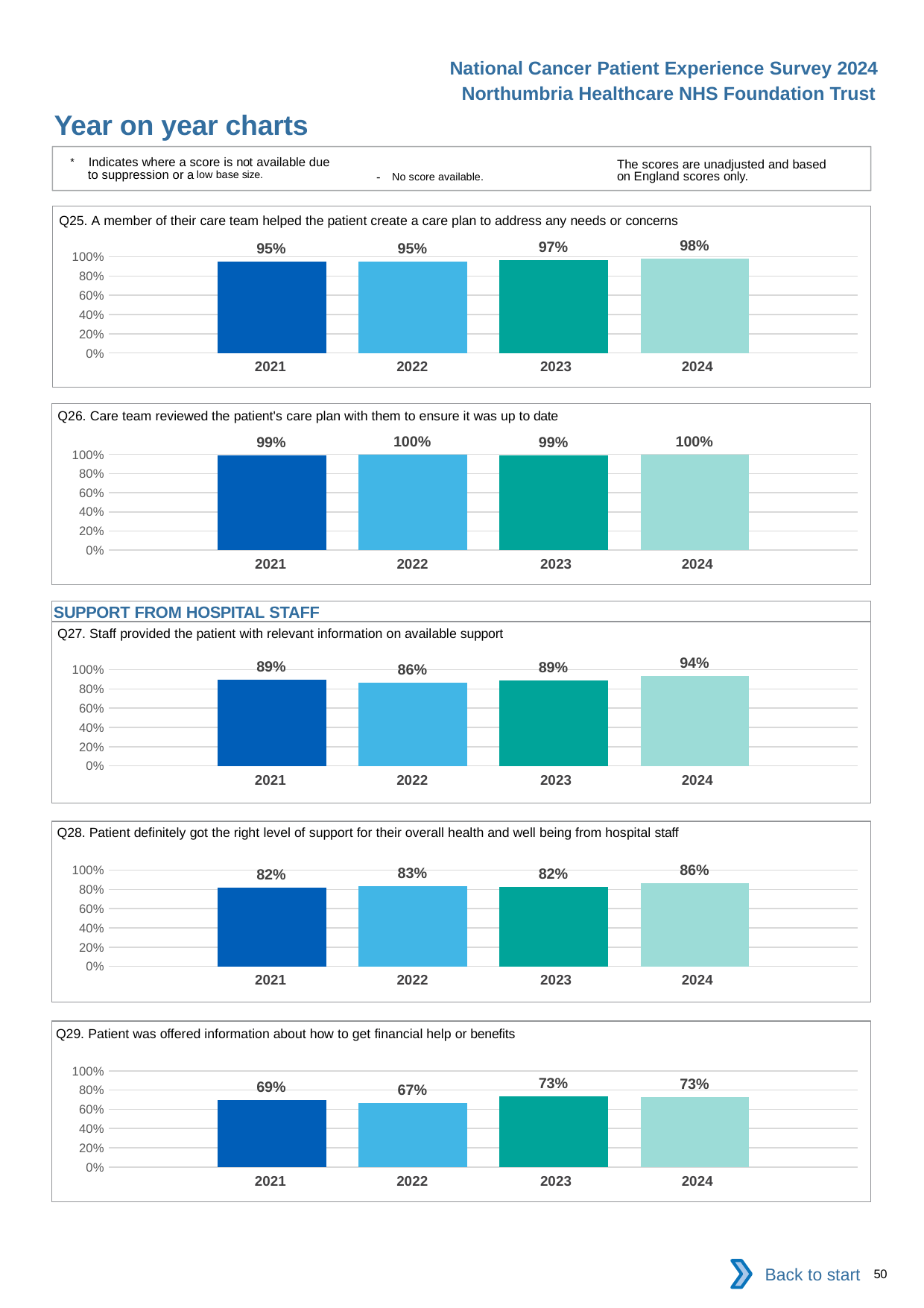
What is the section heading shown above the Q27 chart? SUPPORT FROM HOSPITAL STAFF In the Q28 chart, which year has the highest value? 2024 In the Q27 chart, what is the difference between the 2024 value and the 2022 value? 8% In the Q25 chart, how many years are plotted? 4 In the Q25 chart, what is the value for 2024? 98% In the Q27 chart, what is the value for 2022? 86% In the Q29 chart, what is the value for 2021? 69% In the Q29 chart, which year has the lowest value? 2022 In the Q29 chart, is the value for 2023 greater or less than 80%? less In the Q26 chart, which years have the highest value? 2022 and 2024 In the Q28 chart, is the value for 2022 larger than the value for 2021? Yes What type of chart is used for Q26? Bar chart